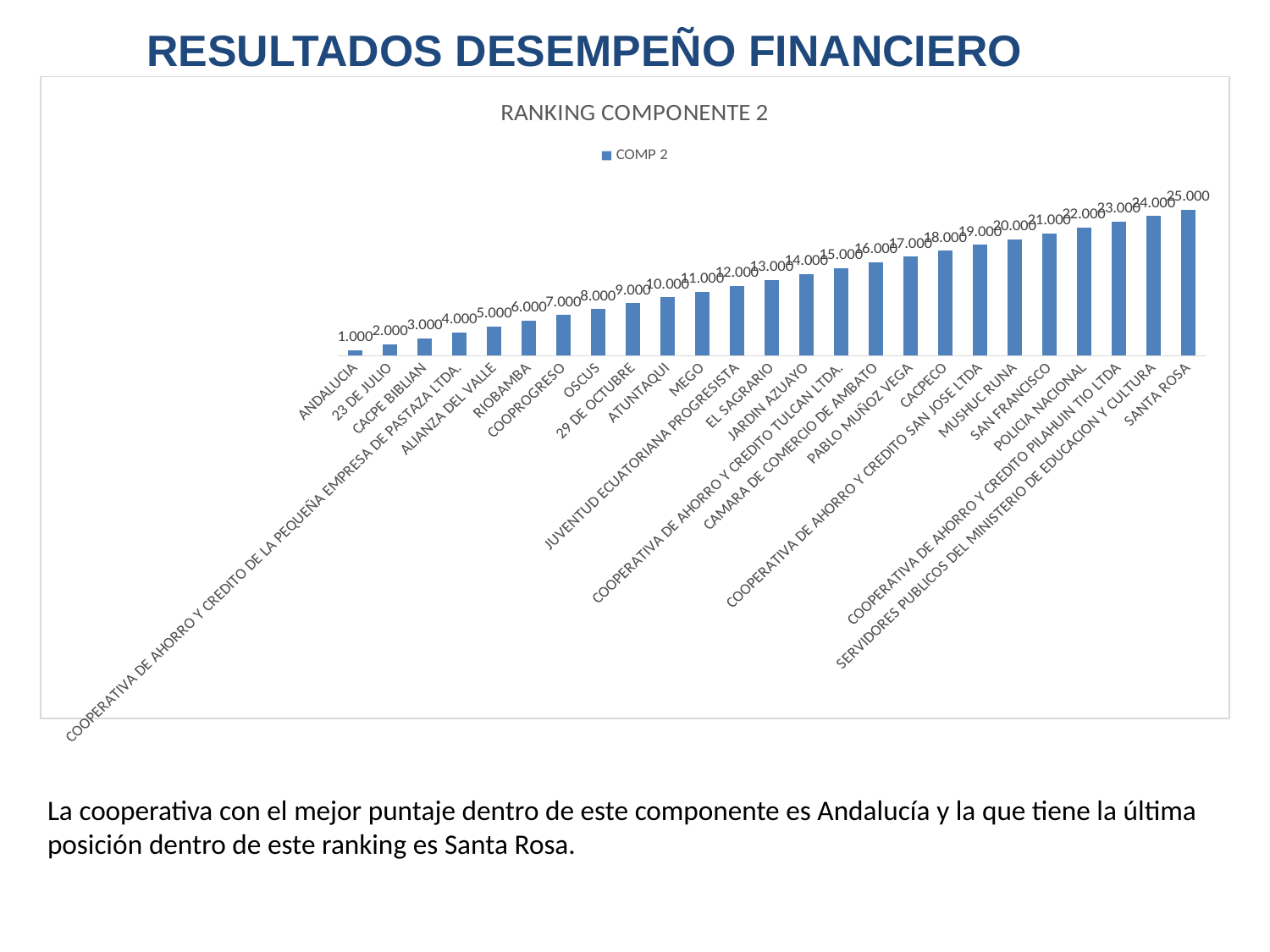
What is the COMP 2 value for CACPECO? 18.000 How many series does the legend list? 1 What type of chart is shown on the slide? Bar chart What is the COMP 2 value for ANDALUCIA? 1.000 What is the COMP 2 value for SANTA ROSA? 25.000 Do the COMP 2 values rise or fall from left to right along the x axis? Rise What is the difference between the COMP 2 values for POLICIA NACIONAL and OSCUS? 14.000 What is the COMP 2 value for MEGO? 11.000 What is the title of the chart? RANKING COMPONENTE 2 Which category has the lowest COMP 2 value? ANDALUCIA Which category has the highest COMP 2 value? SANTA ROSA How many categories are plotted in the chart? 25